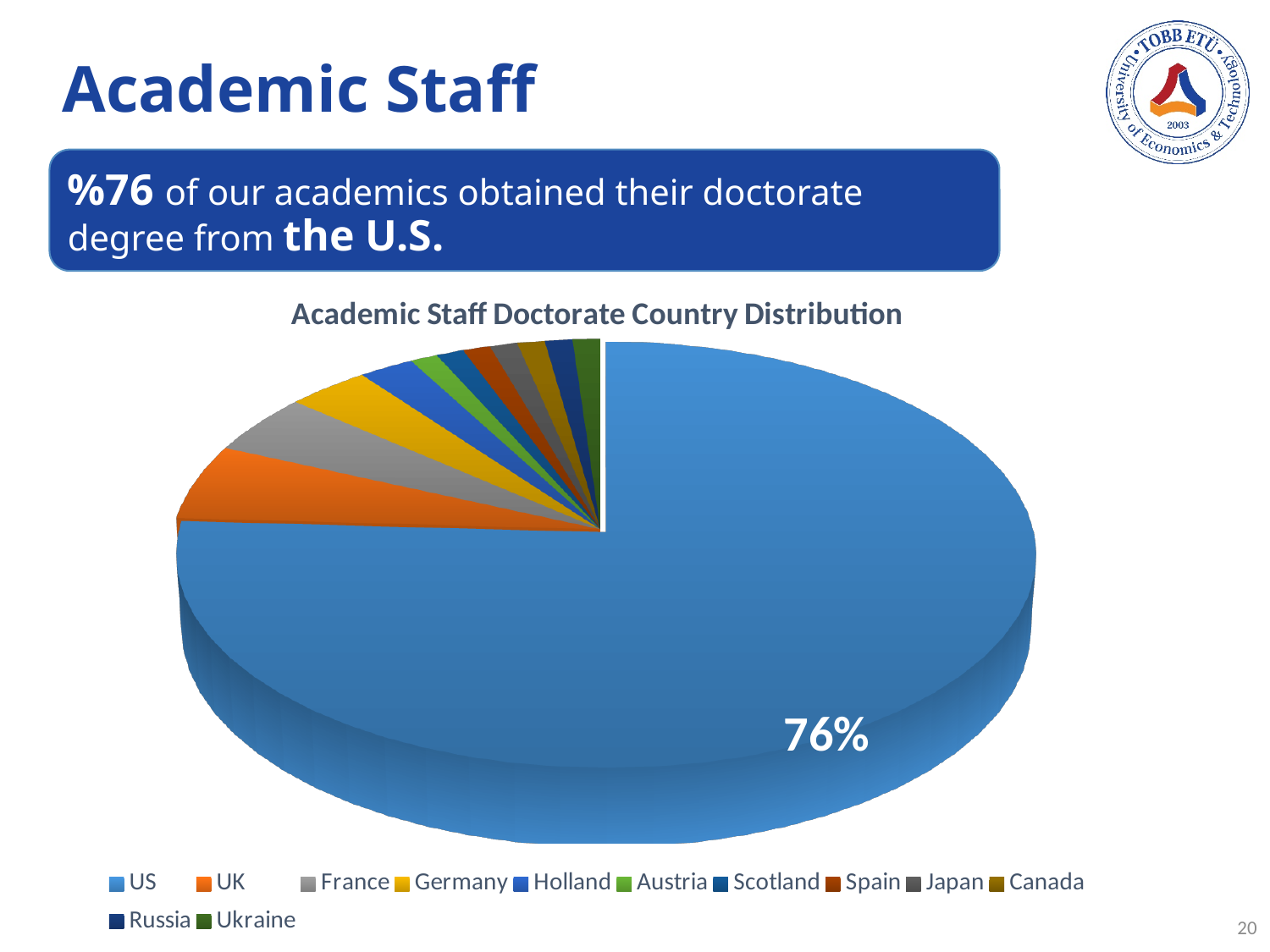
What colour is the US slice in the pie chart? Blue What is the title of the chart? Academic Staff Doctorate Country Distribution Which slice is larger, UK or Ukraine? UK What is the value shown for the US in the chart? 76% What share of the pie does the US slice represent? 76% Which country has the largest slice in the pie chart? US Which country is listed second in the chart's legend? UK Which slice is larger, US or UK? US What kind of chart is shown on the slide? Pie chart How many countries are listed in the chart's legend? 12